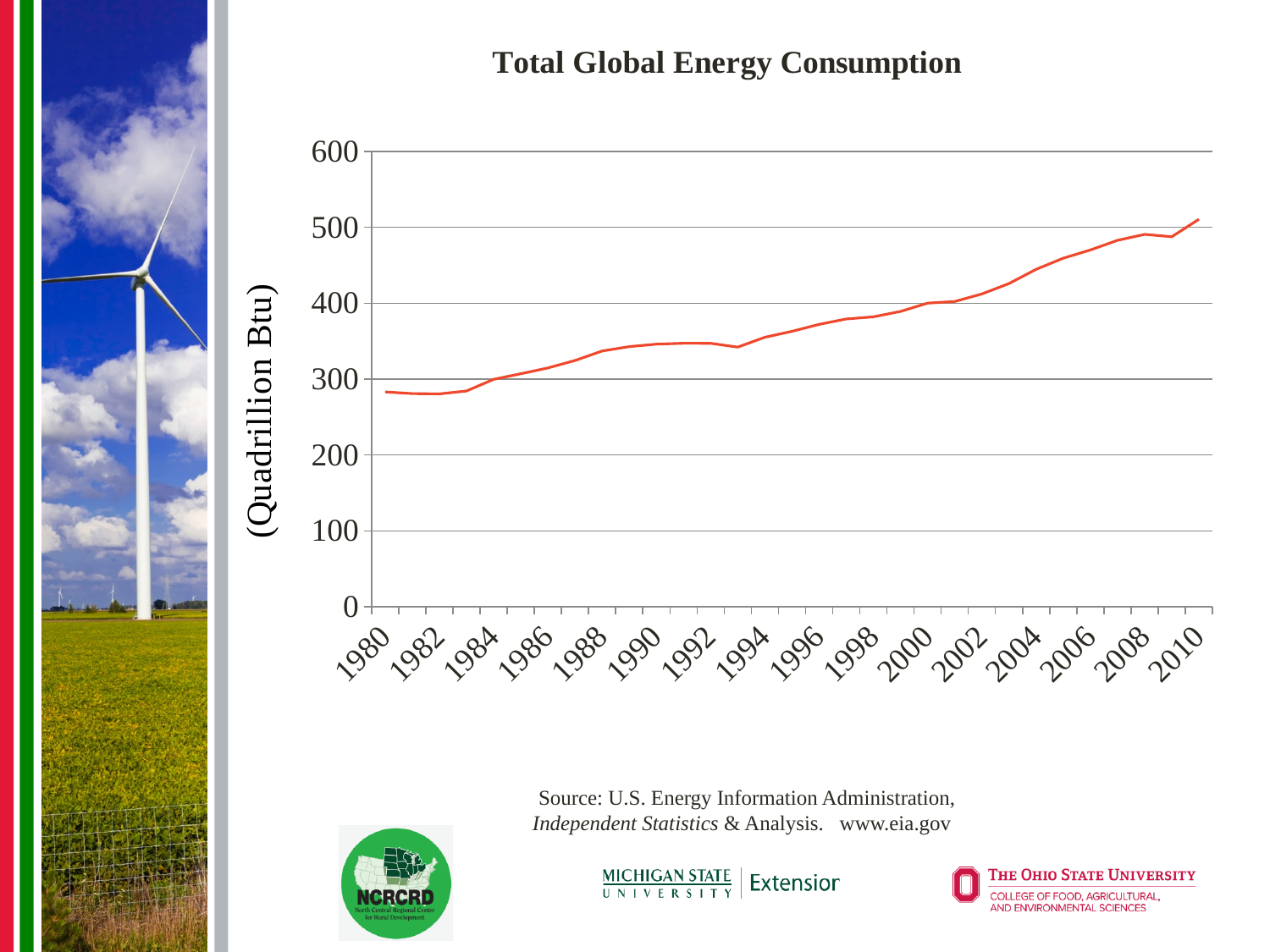
Which year has the highest value in the chart? 2010 How many year labels are shown on the horizontal axis? 16 Is the value for 2010 greater or less than 500? greater What kind of chart is shown on the slide? line chart Is the value for 2005 greater or less than 400? greater Do the values in the chart generally rise or fall from 1980 to 2010? rise What unit is shown on the vertical axis of the chart? Quadrillion Btu Which year has the larger value, 1990 or 2000? 2000 Is the value for 1986 greater or less than 300? greater What is the title of the chart? Total Global Energy Consumption